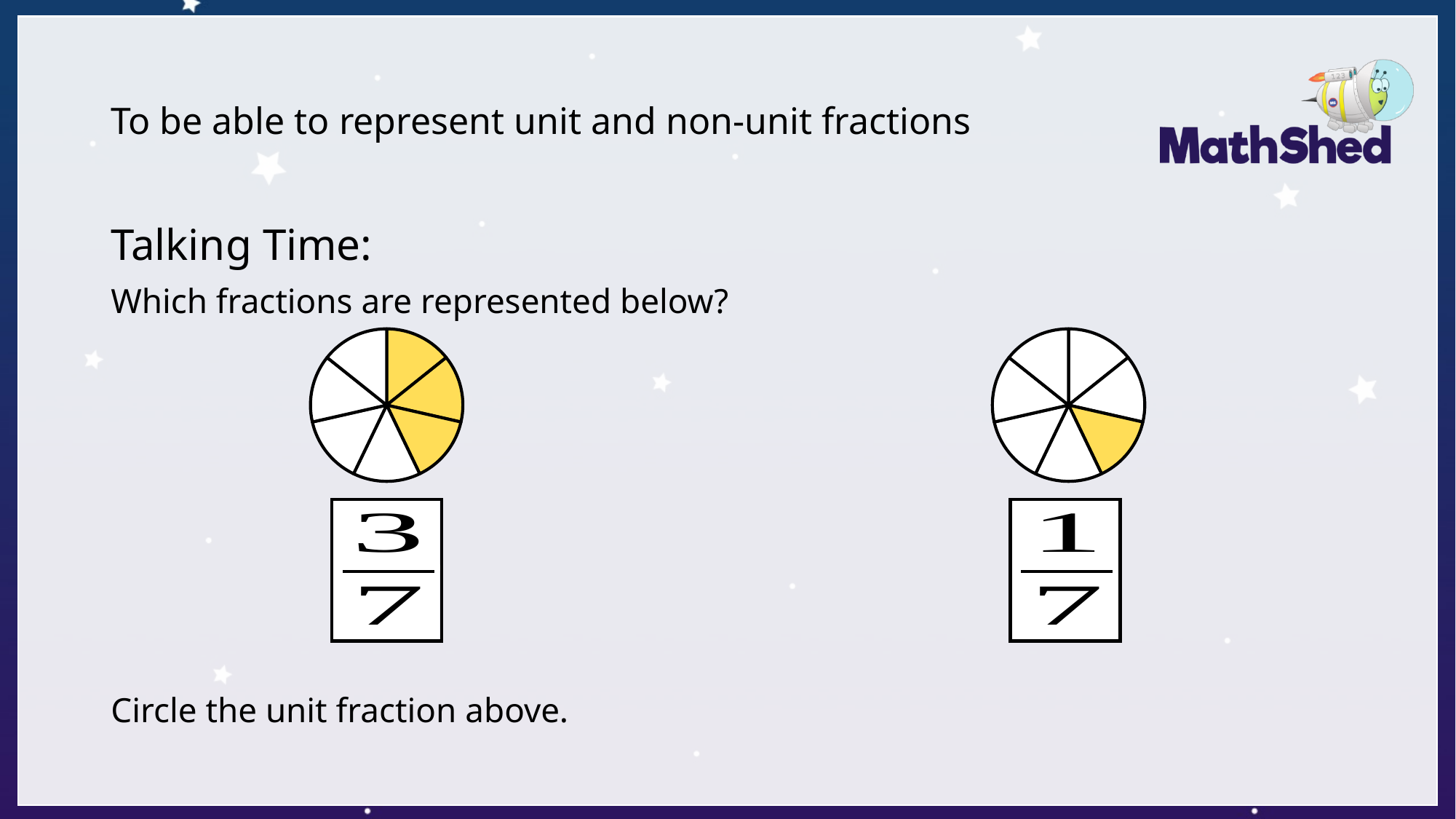
What share of the left circle is shaded yellow? 3/7 What colour are the shaded parts in both circles? yellow How many more parts are shaded in the left circle than in the right circle? 2 What fraction is printed below the left circle? 3/7 How many parts of the left circle are shaded yellow? 3 What kind of chart is the left diagram on the slide? pie chart What share of the right circle is shaded yellow? 1/7 Which circle has the larger shaded share, the left or the right? left How many parts of the right circle are shaded yellow? 1 How many equal parts is the left circle divided into? 7 What fraction is printed below the right circle? 1/7